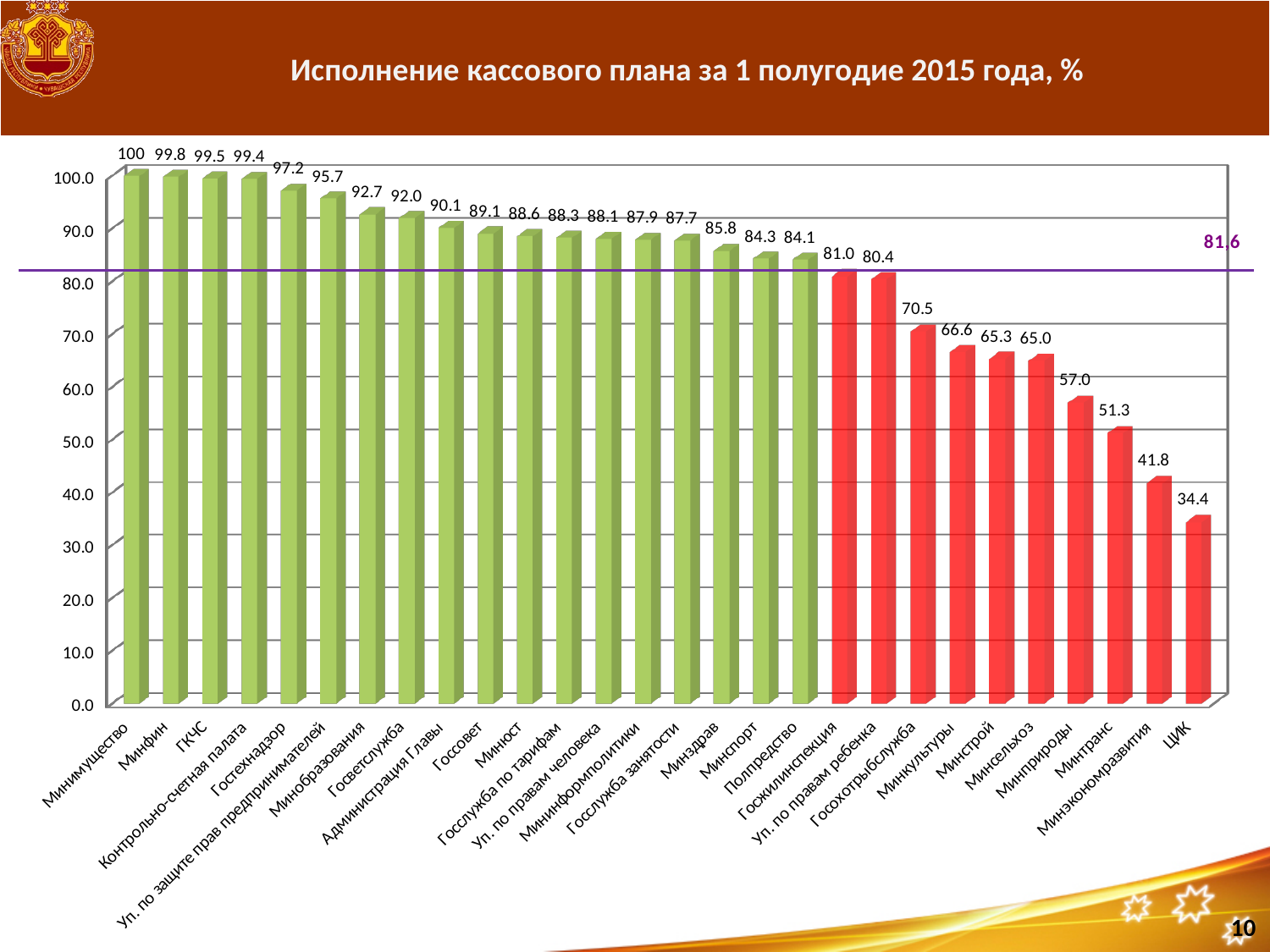
How many categories are shown on the chart? 28 What is the value for Минфин? 99.8 What is the value for Минкультуры? 66.6 What value is marked by the horizontal line across the chart? 81.6 Which category has the highest value? Минимущество Which category has the lowest value? ЦИК What is the value for ЦИК? 34.4 Is the value for Минэкономразвития greater or less than 50.0? less Which is larger, the value for Госохотрыбслужба or the value for Минприроды? Госохотрыбслужба What is the value for Госжилинспекция? 81.0 What is the difference between the values for Минздрав and Минтранс? 34.5 What kind of chart is shown on the slide? bar chart